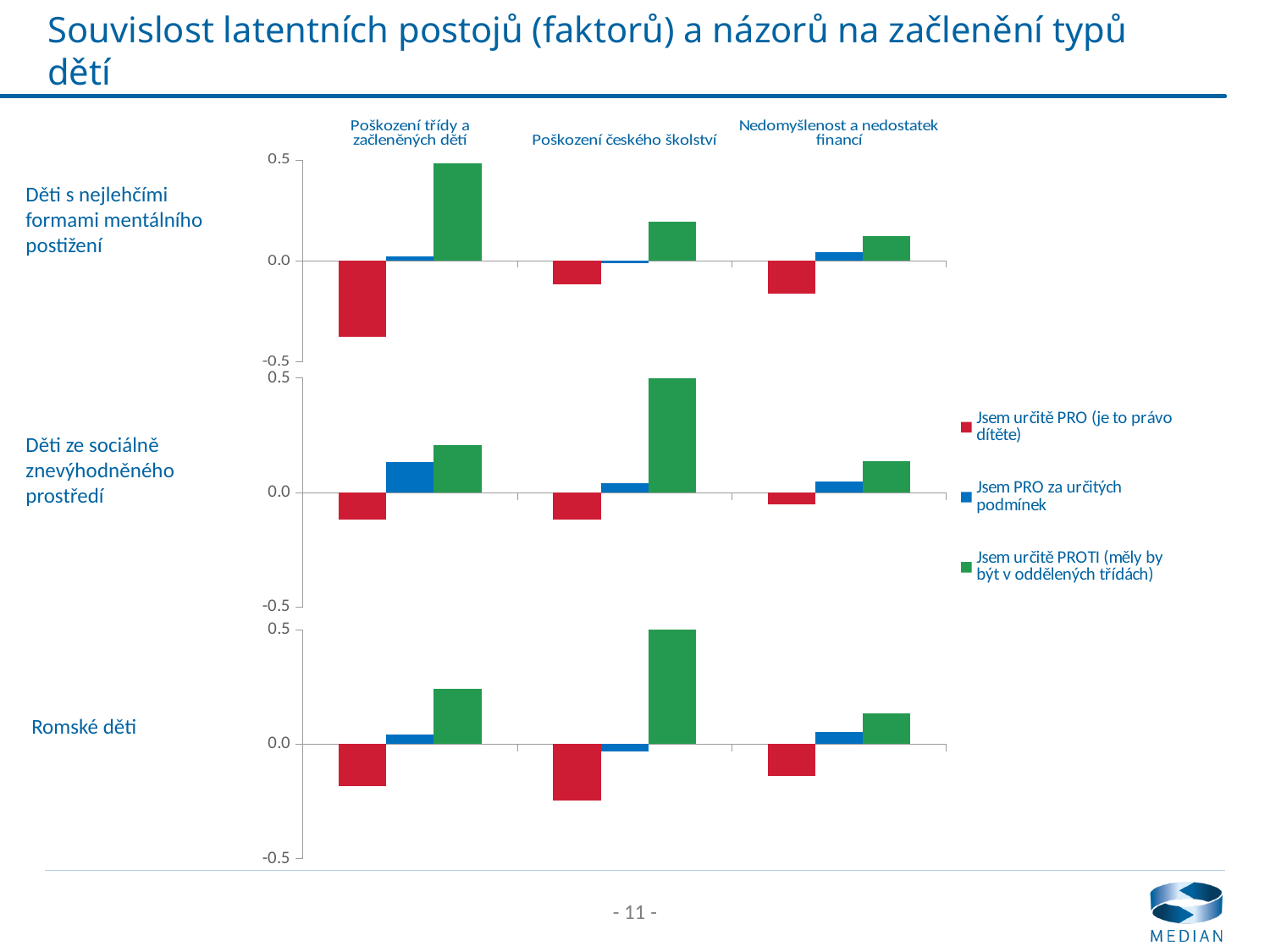
In the top chart (Děti s nejlehčími formami mentálního postižení), which category has the highest value for 'Jsem určitě PROTI (měly by být v oddělených třídách)'? Poškození třídy a začleněných dětí In the top chart (Děti s nejlehčími formami mentálního postižení), is the value of 'Jsem určitě PRO (je to právo dítěte)' for 'Poškození třídy a začleněných dětí' greater or less than 0.0? less In the bottom chart (Romské děti), which category has the lowest value for 'Jsem určitě PRO (je to právo dítěte)'? Poškození českého školství In the top chart (Děti s nejlehčími formami mentálního postižení), which category has the lowest value for 'Jsem určitě PRO (je to právo dítěte)'? Poškození třídy a začleněných dětí How many categories are shown on the x axis of the bottom chart (Romské děti)? 3 In the bottom chart (Romské děti), which category has the highest value for 'Jsem určitě PROTI (měly by být v oddělených třídách)'? Poškození českého školství In the middle chart (Děti ze sociálně znevýhodněného prostředí), which is larger for 'Jsem PRO za určitých podmínek': 'Poškození třídy a začleněných dětí' or 'Nedomyšlenost a nedostatek financí'? Poškození třídy a začleněných dětí In the middle chart (Děti ze sociálně znevýhodněného prostředí), is the value of 'Jsem určitě PRO (je to právo dítěte)' for 'Poškození českého školství' greater or less than 0.0? less How many series does the legend list? 3 Which colour represents the series 'Jsem určitě PROTI (měly by být v oddělených třídách)' in the legend? green What kind of chart is the top chart (Děti s nejlehčími formami mentálního postižení)? bar chart In the top chart (Děti s nejlehčími formami mentálního postižení), is the value of 'Jsem určitě PROTI (měly by být v oddělených třídách)' for 'Poškození třídy a začleněných dětí' greater or less than 0.0? greater